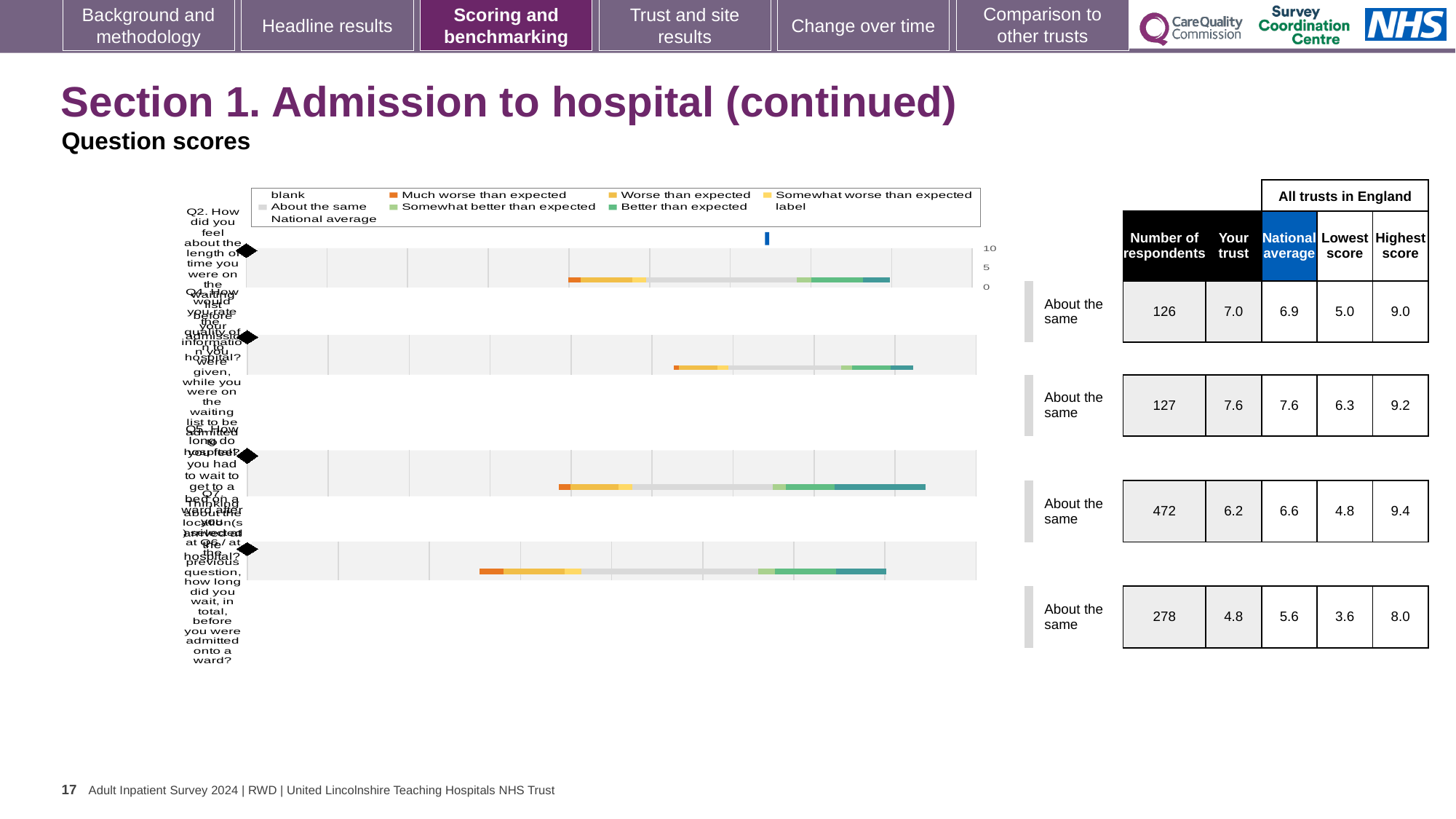
In the table beside the chart, what is the 'Your trust' score for the second row? 7.6 In the table beside the chart, which row has the highest number of respondents? the third row (472) Which legend entry is shown in dark orange? Much worse than expected In the table beside the chart, is the 'Your trust' score in the fourth row larger or smaller than the national average in that row? smaller What benchmark label is shown next to each of the four bars? About the same What is the highest value shown on the chart's axis? 10 How many entries does the chart legend list? 9 What kind of chart is shown on the slide? bar chart In the table beside the chart, what is the number of respondents for the first row? 126 In the table beside the chart, what is the national average for the fourth row? 5.6 How many horizontal bars are plotted in the chart? 4 In the table beside the chart, what is the difference between the highest score and lowest score in the third row? 4.6